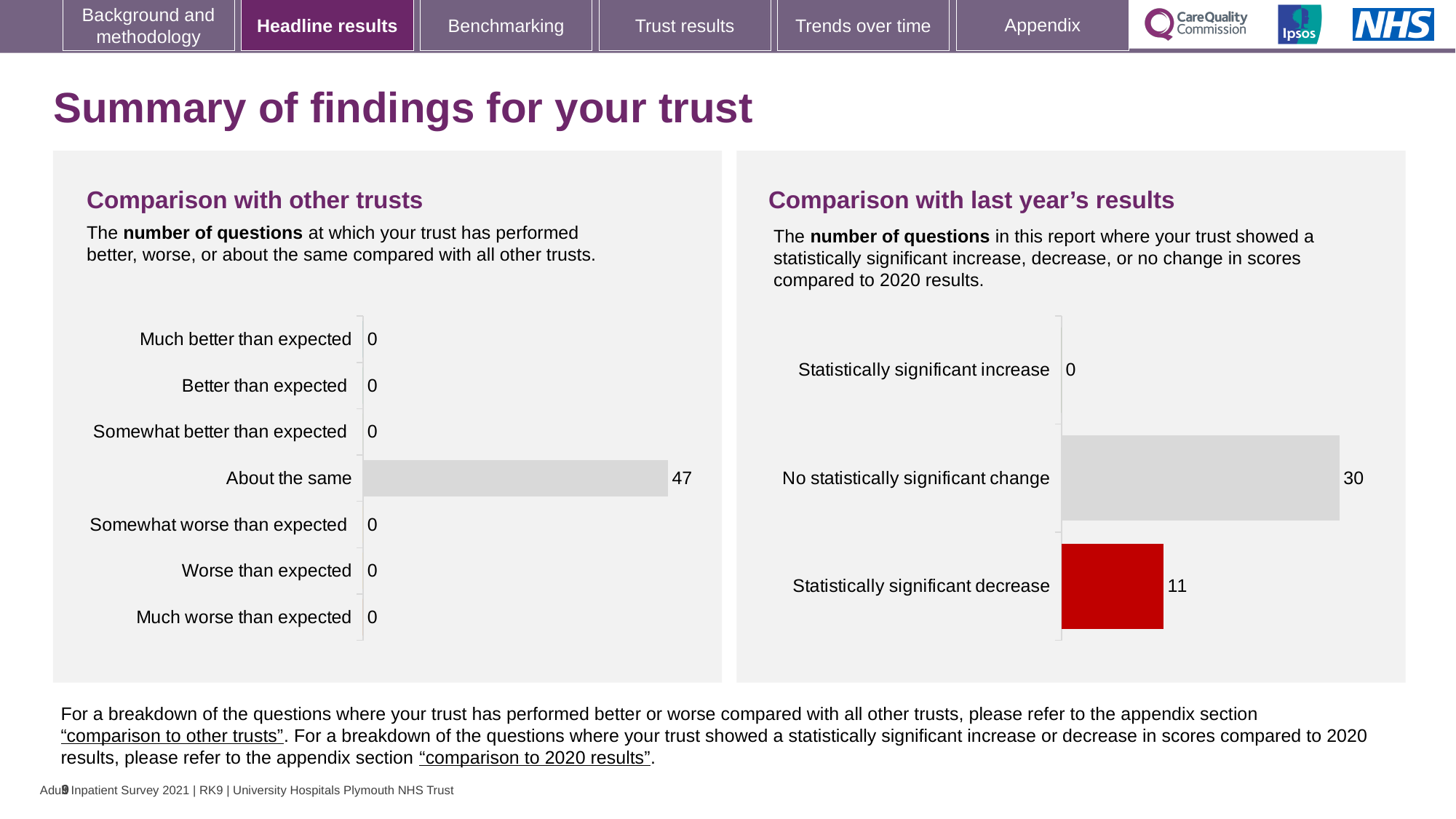
In the 'Comparison with last year's results' chart, what colour is the bar for 'Statistically significant decrease'? Red In the 'Comparison with last year's results' chart, what is the difference between 'No statistically significant change' and 'Statistically significant decrease'? 19 In the 'Comparison with last year's results' chart, which category has the lowest value? Statistically significant increase In the 'Comparison with other trusts' chart, what is the value for 'Much better than expected'? 0 In the 'Comparison with last year's results' chart, what is the value for 'Statistically significant decrease'? 11 How many categories are shown in the 'Comparison with last year's results' chart? 3 How many categories are shown in the 'Comparison with other trusts' chart? 7 In the 'Comparison with other trusts' chart, what is the value for 'About the same'? 47 In the 'Comparison with last year's results' chart, what is the value for 'Statistically significant increase'? 0 What type of chart is the 'Comparison with other trusts' chart? Bar chart In the 'Comparison with other trusts' chart, which category has the highest value? About the same In the 'Comparison with last year's results' chart, what is the value for 'No statistically significant change'? 30